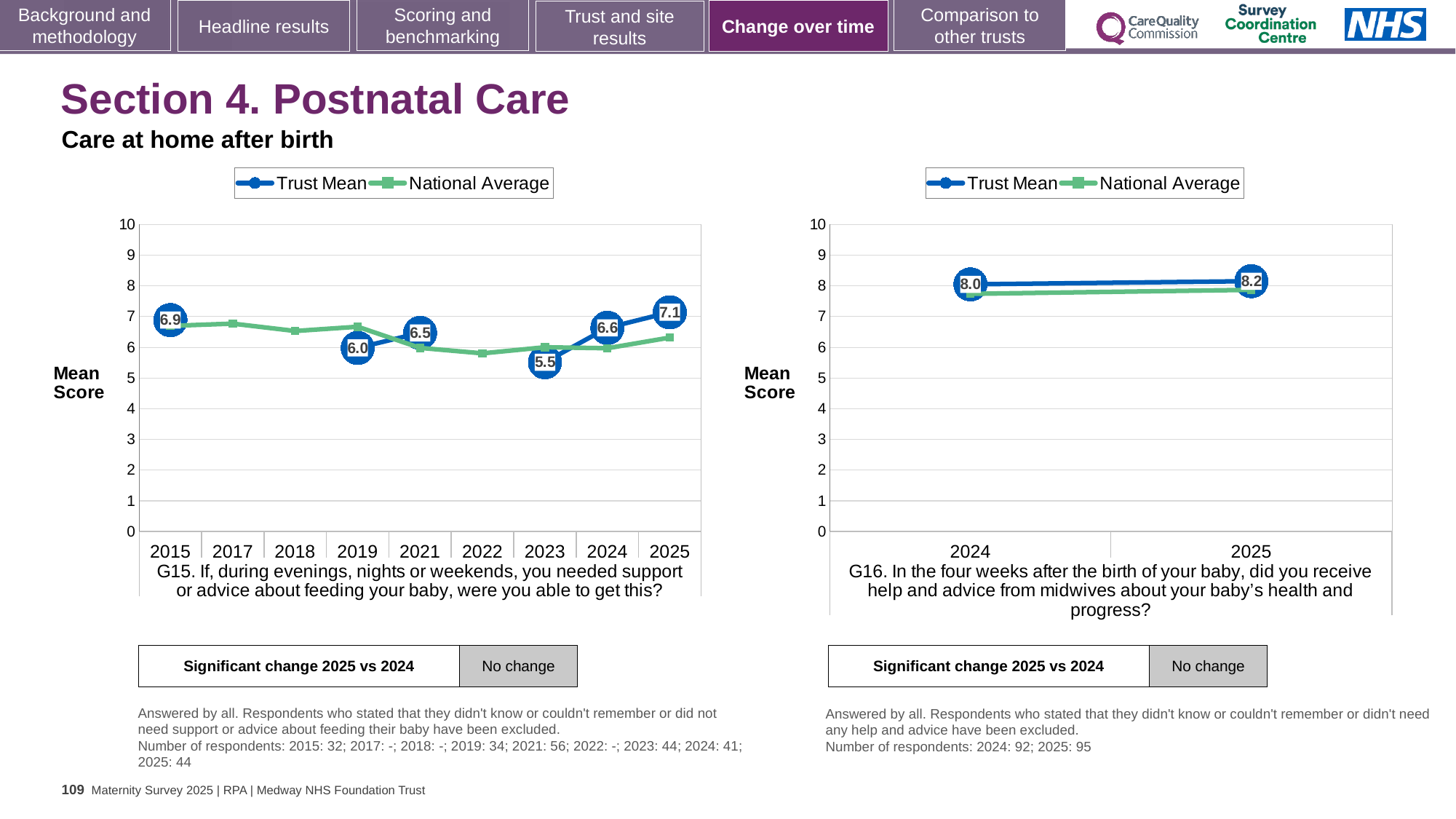
On the left chart (G15), how many years are shown on the x axis? 9 On the right chart (G16), what is the difference between the Trust Mean in 2025 and in 2024? 0.2 On the left chart (G15), which year has the lowest labelled Trust Mean? 2023 On the left chart (G15), is the National Average for 2022 greater or less than 6? less On the left chart (G15), what is the difference between the Trust Mean in 2025 and in 2024? 0.5 On the left chart (G15), which year has the highest labelled Trust Mean? 2025 On the right chart (G16), how many series does the legend list? 2 On the right chart (G16), what is the Trust Mean for 2024? 8.0 On the left chart (G15), what is the Trust Mean for 2015? 6.9 On the left chart (G15), is the Trust Mean higher in 2021 or in 2019? 2021 On the left chart (G15), what is the Trust Mean for 2023? 5.5 On the left chart (G15), what is the Trust Mean for 2025? 7.1